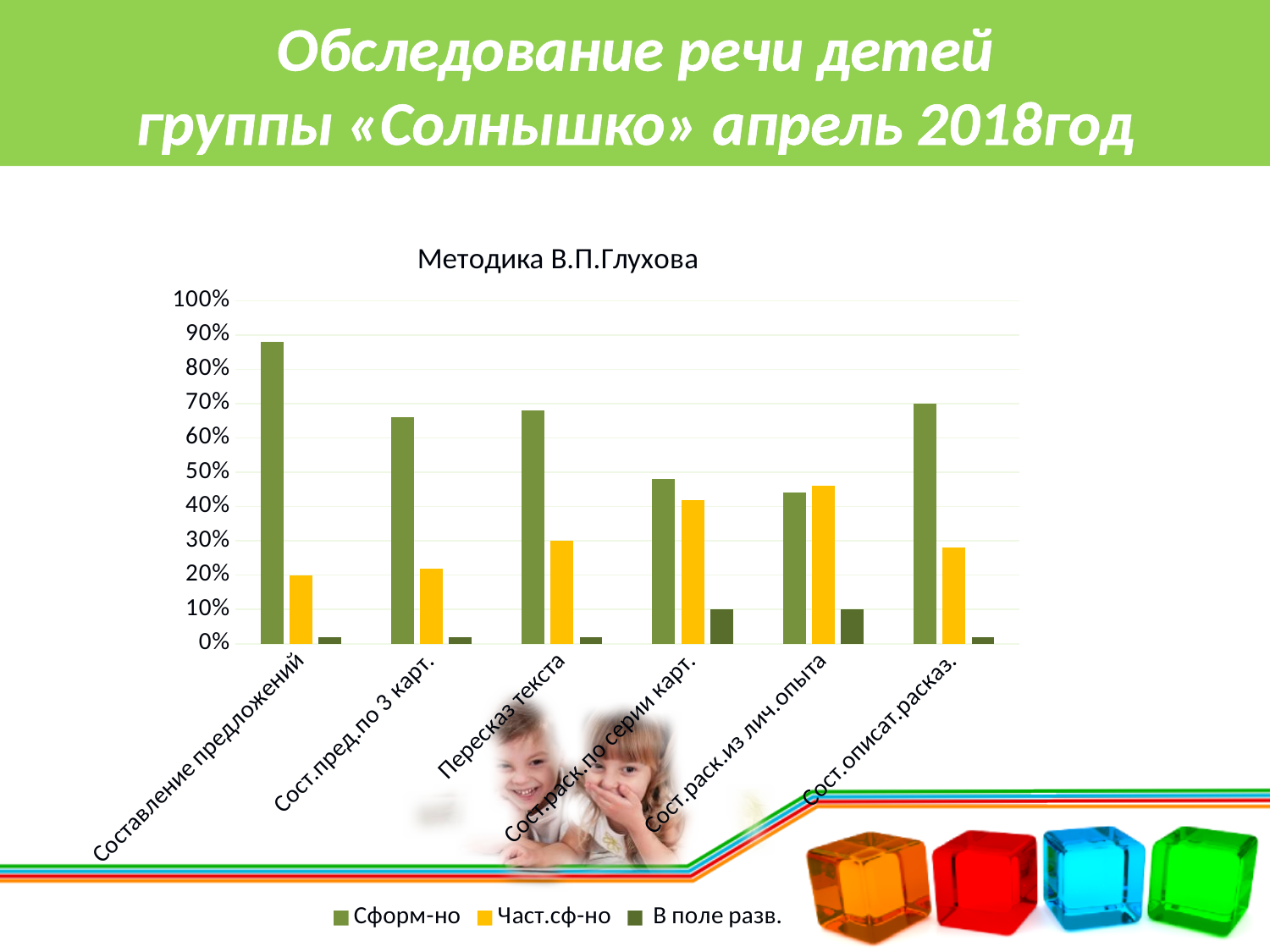
Is the value of Част.сф-но for Пересказ текста greater or less than 40%? less What kind of chart is shown on the slide? bar chart For Составление предложений, which is larger: Сформ-но or Част.сф-но? Сформ-но Is the value of Сформ-но for Составление предложений greater or less than 80%? greater Which category has the highest value for the series Сформ-но? Составление предложений Is the value of Сформ-но for Сост.описат.расказ. greater or less than 60%? greater What is the title of the chart? Методика В.П.Глухова For Пересказ текста, which is larger: Част.сф-но or В поле разв.? Част.сф-но How many categories are shown on the x axis of the chart? 6 Which series is shown in yellow in the chart legend? Част.сф-но How many series does the chart legend list? 3